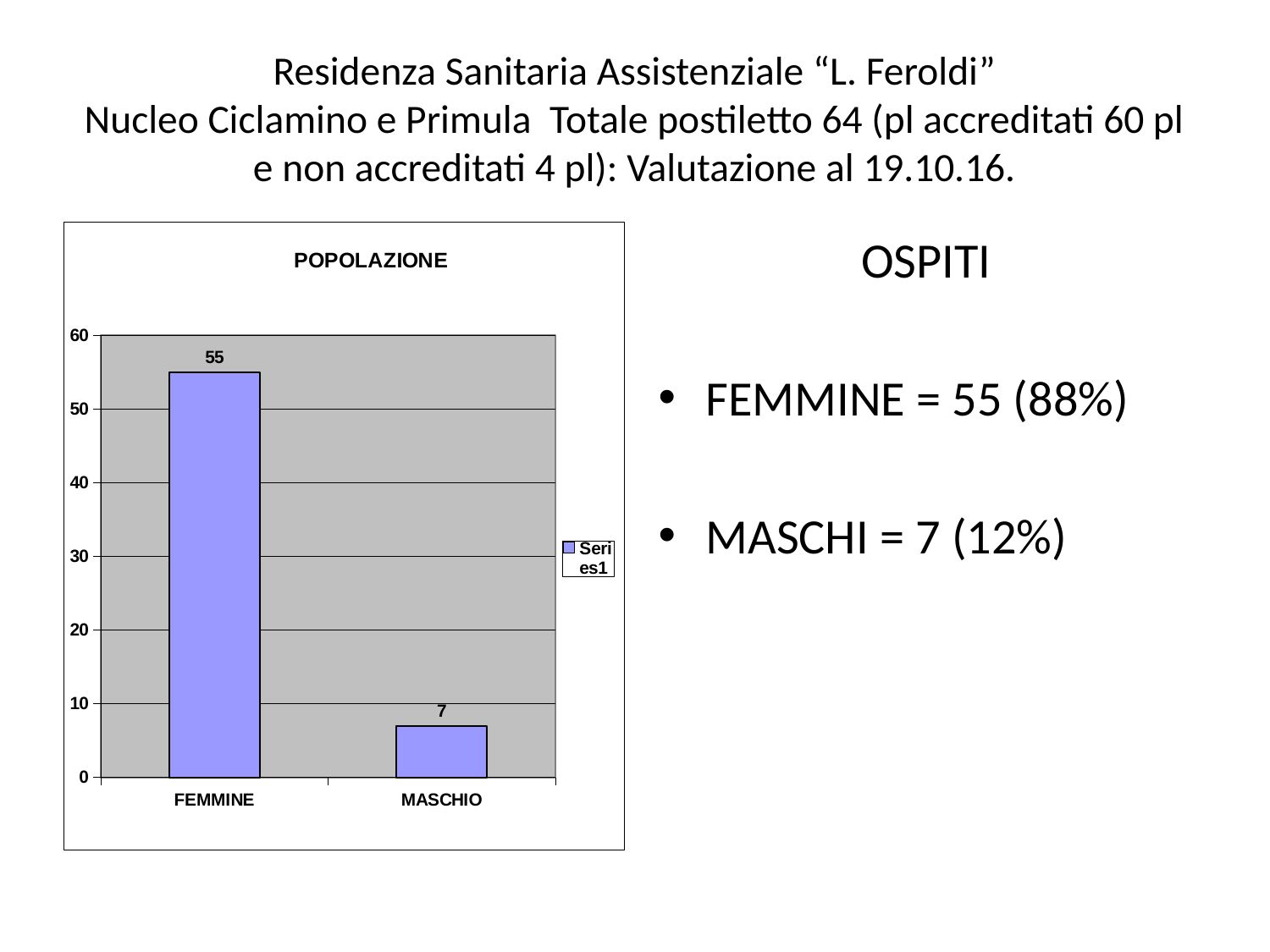
What is the difference between the FEMMINE and MASCHIO values in the POPOLAZIONE chart? 48 What is the value for FEMMINE in the POPOLAZIONE chart? 55 How many categories are shown in the POPOLAZIONE chart? 2 Which is larger in the POPOLAZIONE chart, FEMMINE or MASCHIO? FEMMINE Is the value for MASCHIO greater or less than 10? less What is the title of the chart on the slide? POPOLAZIONE Which category has the highest value in the POPOLAZIONE chart? FEMMINE How many series does the legend of the POPOLAZIONE chart list? 1 What kind of chart is the POPOLAZIONE chart? bar chart Which category has the lowest value in the POPOLAZIONE chart? MASCHIO What is the value for MASCHIO in the POPOLAZIONE chart? 7 Is the value for FEMMINE greater or less than 50? greater